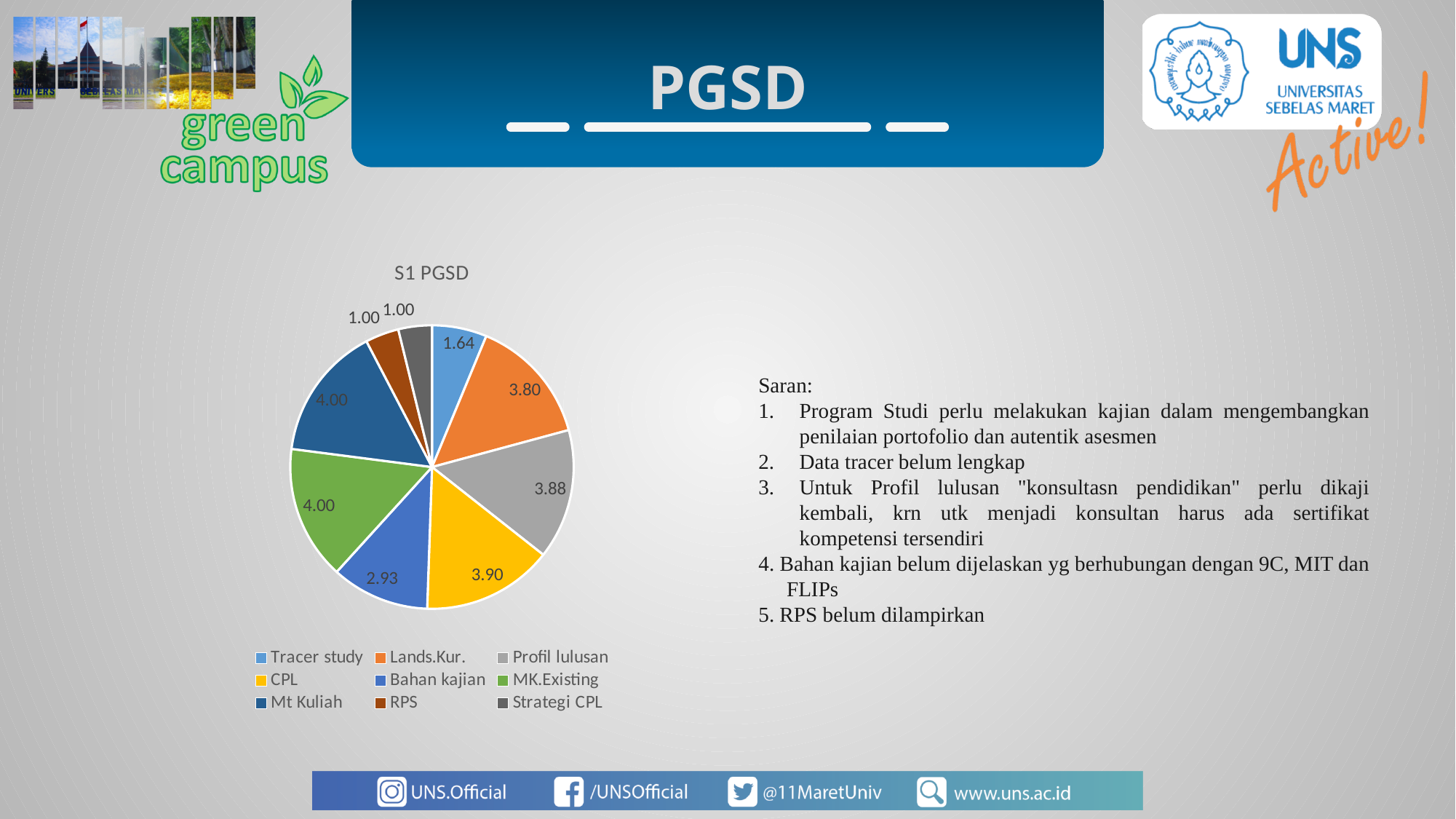
Which is larger in the pie chart, CPL or Bahan kajian? CPL What is the value for Lands.Kur. in the pie chart? 3.80 What is the value for Tracer study in the pie chart? 1.64 What is the value for CPL in the pie chart? 3.90 What is the title of the pie chart? S1 PGSD What type of chart is shown on the slide? pie chart What is the value for MK.Existing in the pie chart? 4.00 What is the difference between the values for CPL and Bahan kajian? 0.97 What is the value for Bahan kajian in the pie chart? 2.93 What is the value for Profil lulusan in the pie chart? 3.88 Which colour represents CPL in the pie chart? yellow How many slices does the pie chart have? 9